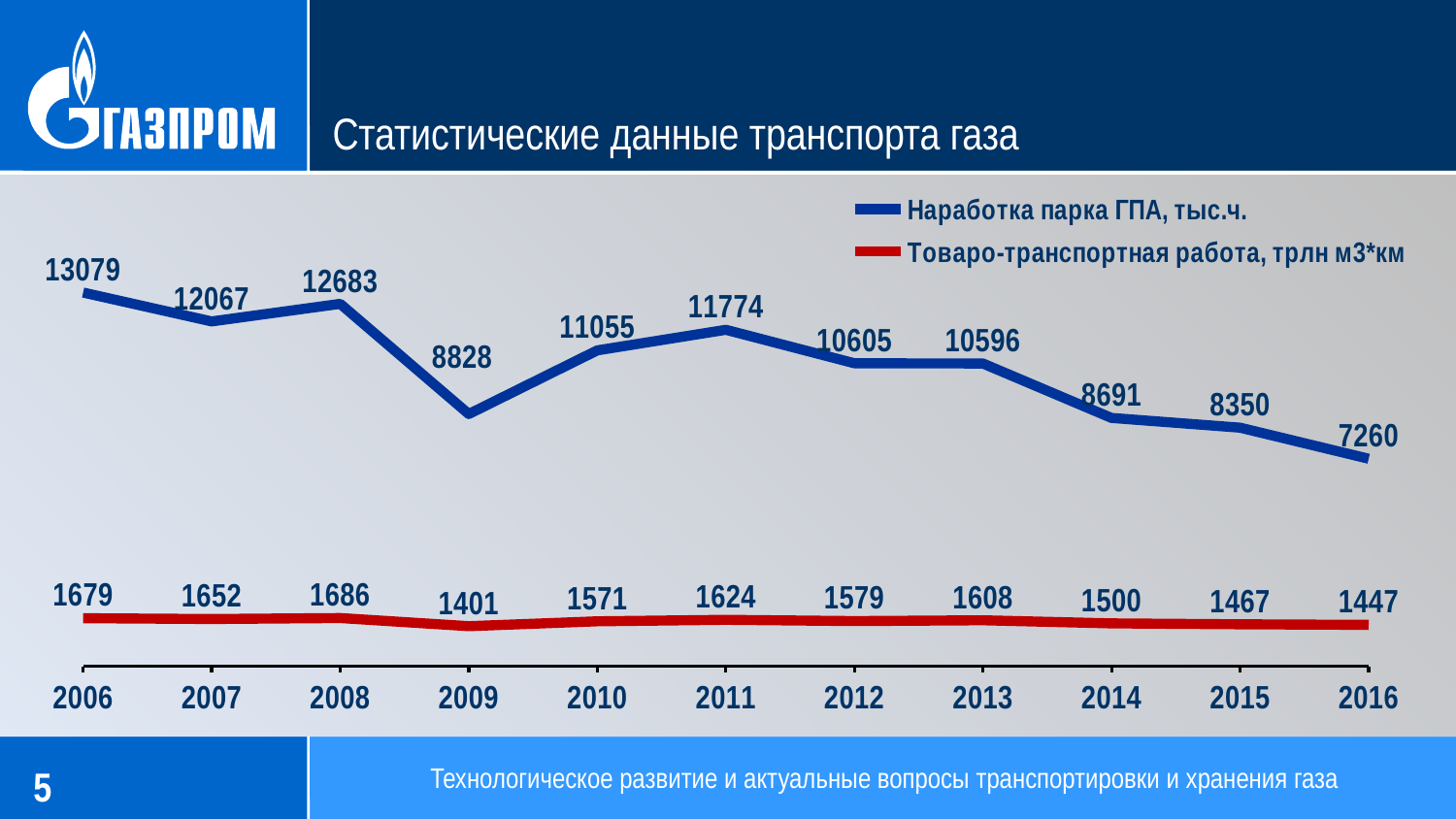
How many series does the legend list? 2 In which year is Наработка парка ГПА, тыс.ч. highest? 2006 What is the difference between the Наработка парка ГПА values for 2006 and 2016? 5819 Which is larger: Товаро-транспортная работа in 2008 or in 2010? 2008 What is the difference between the Товаро-транспортная работа values for 2011 and 2012? 45 What colour is the line for Товаро-транспортная работа, трлн м3*км? Red What is the value of Наработка парка ГПА, тыс.ч. in 2009? 8828 What is the value of Товаро-транспортная работа, трлн м3*км in 2013? 1608 How many years are shown on the x axis? 11 What type of chart is shown on the slide? Line chart In which year is Товаро-транспортная работа, трлн м3*км lowest? 2009 Does Наработка парка ГПА, тыс.ч. generally rise or fall from 2006 to 2016? Fall